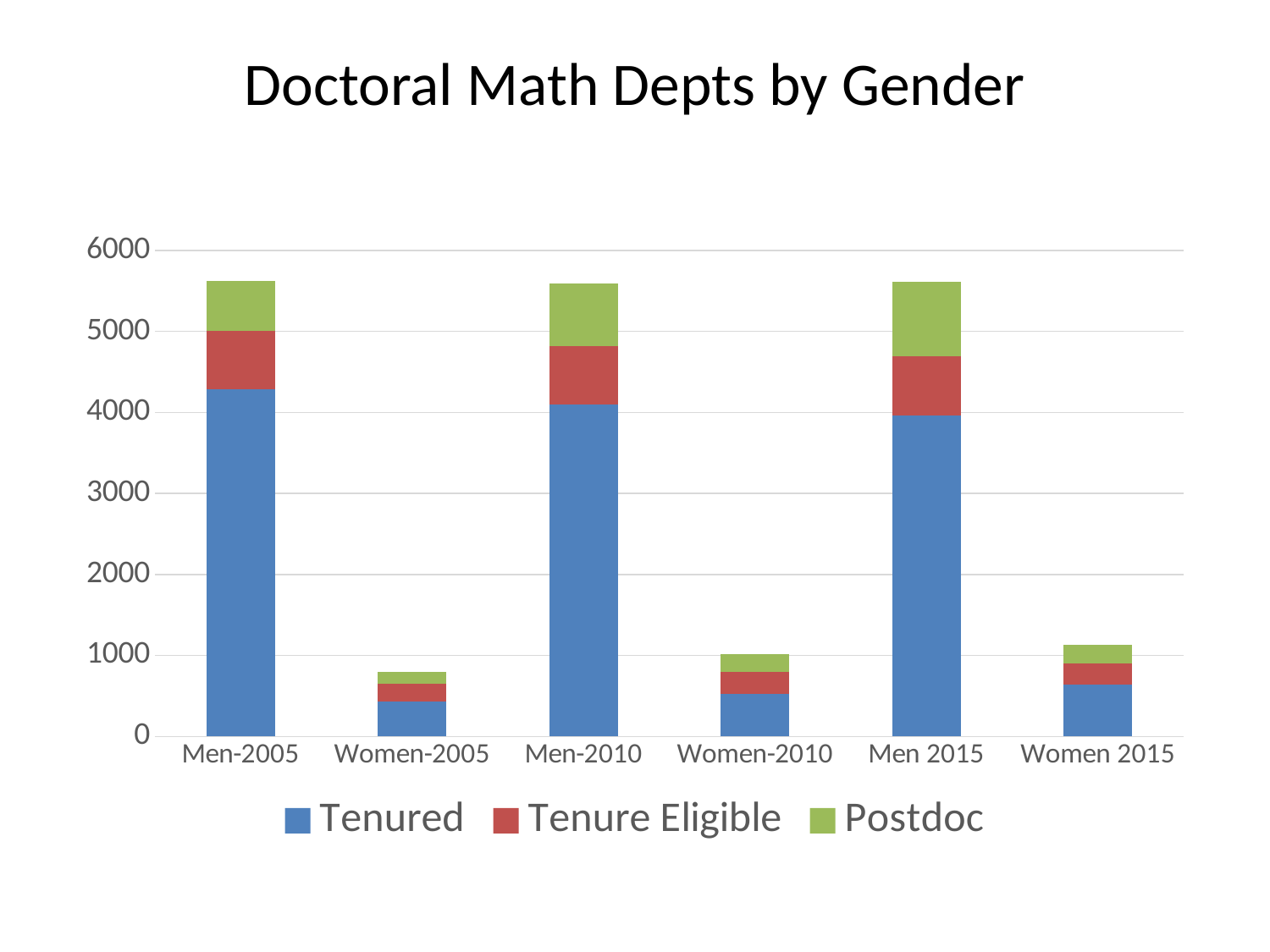
Which is larger, the Postdoc segment for Men 2015 or for Men-2005? Men 2015 Is the Tenured value for Men-2005 greater or less than 4000? greater How many series does the legend list? 3 Is the total for Women-2005 greater or less than 1000? less Which is larger, the total for Men-2010 or the total for Women-2010? Men-2010 Which series is shown in green? Postdoc Which category has the lowest total bar? Women-2005 Is the total for Men-2005 greater or less than 5000? greater What kind of chart is shown on the slide? stacked bar chart What is the title of the chart? Doctoral Math Depts by Gender How many categories are shown on the x axis? 6